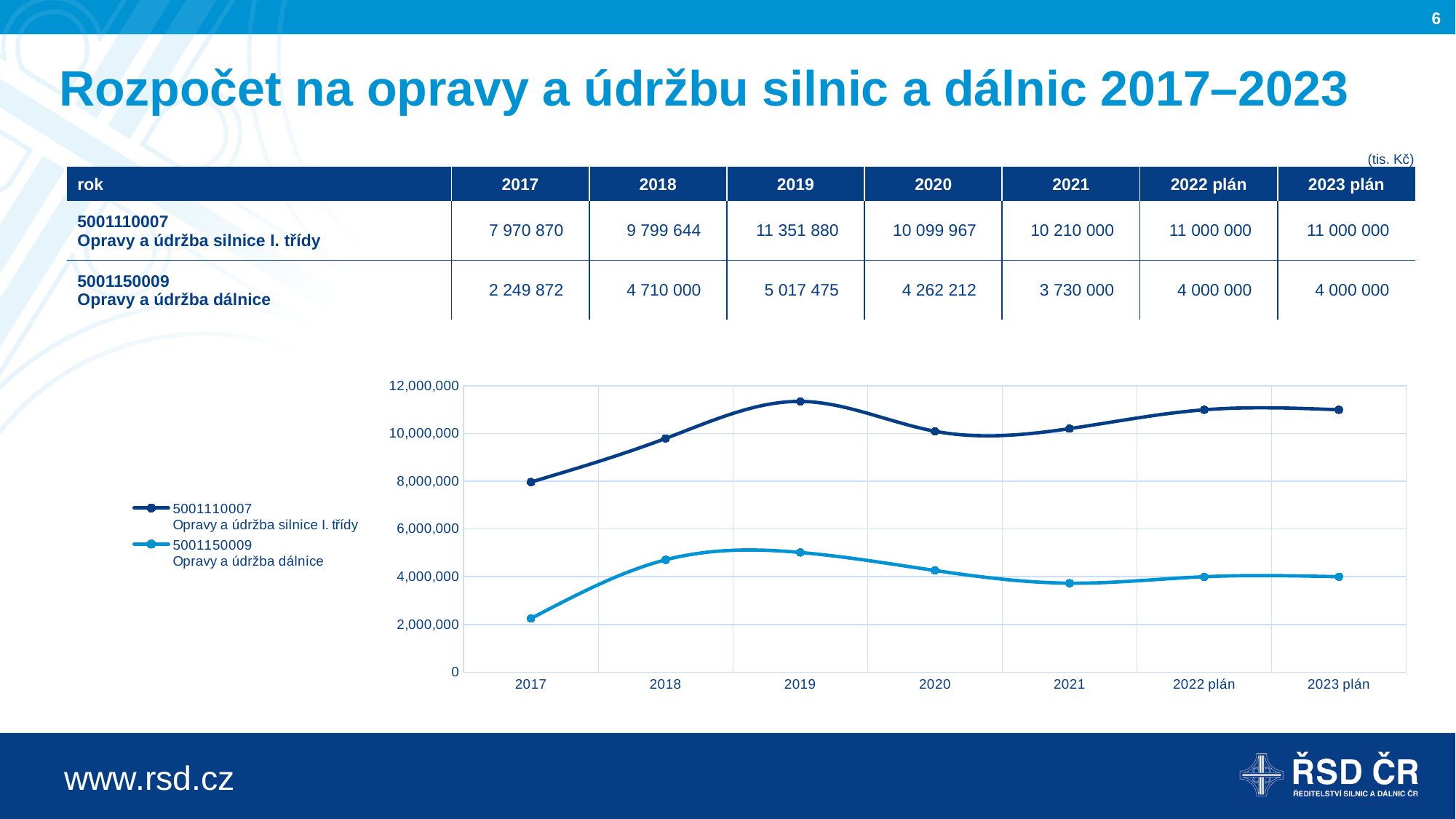
In which year is the value for Opravy a údržba silnice I. třídy the highest? 2019 In what unit are the values on the slide given? tis. Kč Which is larger for Opravy a údržba silnice I. třídy: the value in 2018 or the value in 2021? 2021 What kind of chart is shown on the slide? line chart Does the line for Opravy a údržba silnice I. třídy rise or fall from 2017 to 2019? rise How many years (points) are plotted along the x axis of the chart? 7 What is the value for 5001150009 Opravy a údržba dálnice in 2017? 2 249 872 Is the value for Opravy a údržba dálnice in 2019 greater or less than 4,000,000? greater What is the value for 5001110007 Opravy a údržba silnice I. třídy in 2019? 11 351 880 How many series does the chart legend list? 2 What is the difference between Opravy a údržba silnice I. třídy and Opravy a údržba dálnice in 2022 plán? 7 000 000 In which year is the value for Opravy a údržba dálnice the lowest? 2017